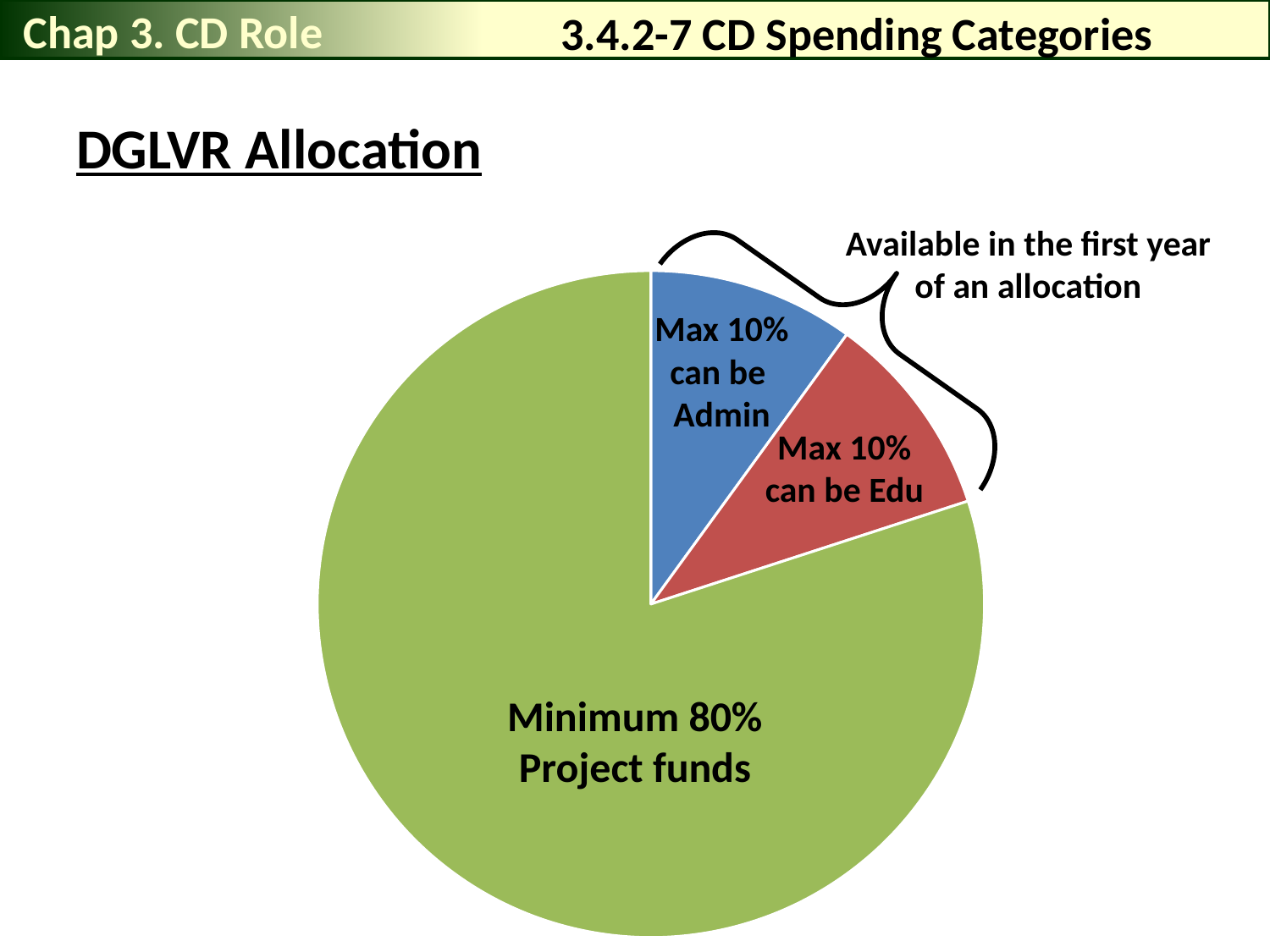
What is the difference between the Project funds share and the Edu share? 70% Which is larger, the Project funds slice or the Admin slice? Project funds What is the combined share of the Admin and Edu slices? 20% What share of the DGLVR allocation is shown for Project funds? Minimum 80% What share of the DGLVR allocation can be Admin? Max 10% What is the title of the chart? DGLVR Allocation How many slices does the pie chart have? 3 Which slice of the pie chart is the largest? Minimum 80% Project funds What share of the DGLVR allocation can be Edu? Max 10% What colour is the Project funds slice? green What kind of chart is shown on the slide? pie chart